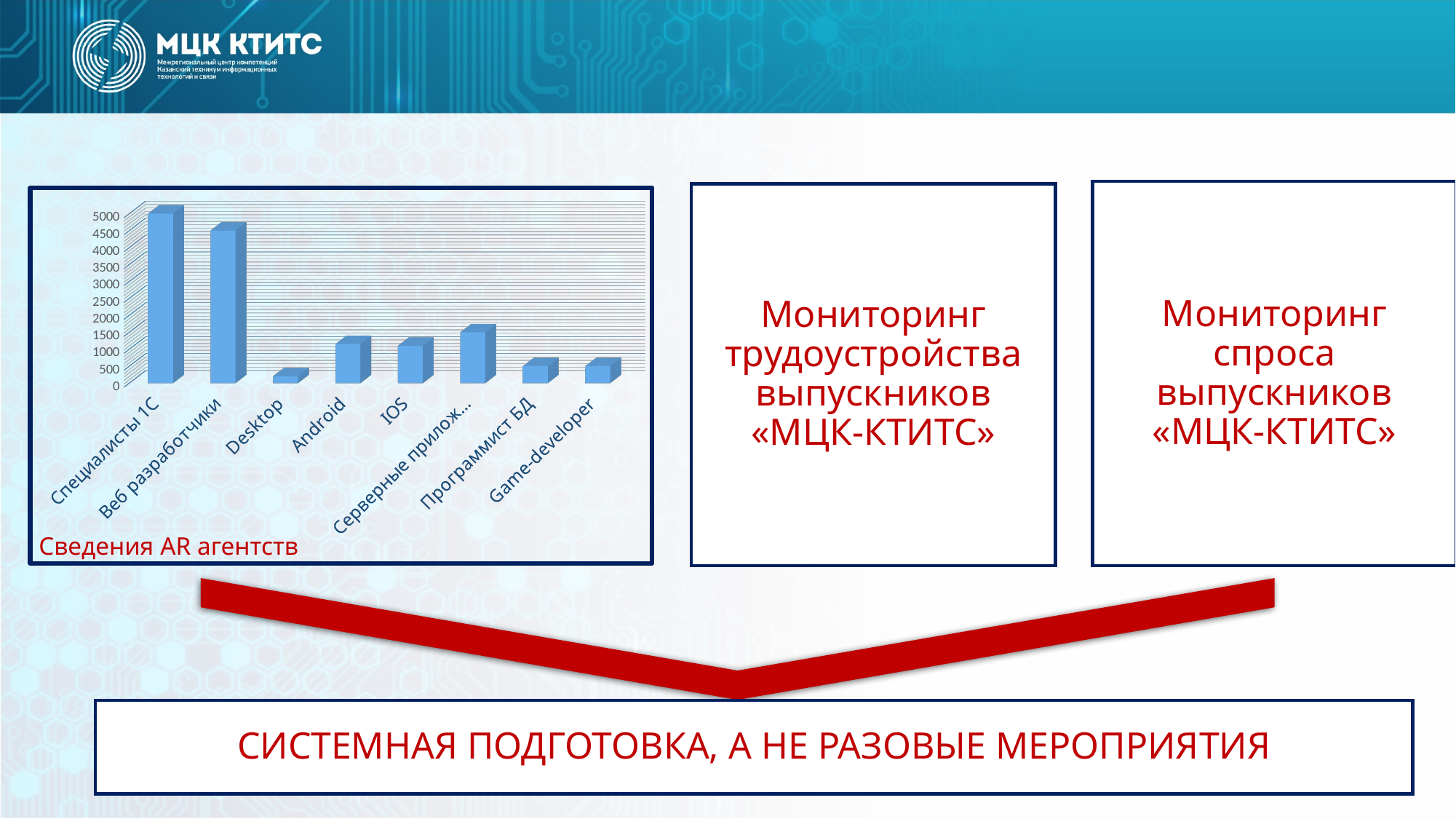
Is the value for Программист БД greater or less than 1000? less Is the value for Desktop greater or less than 500? less Which is larger, the value for Android or the value for Desktop? Android Is the value for Специалисты 1С greater or less than 4000? greater What caption is written below the chart? Сведения AR агентств Which category has the highest bar in the chart? Специалисты 1С How many categories are shown on the x axis of the chart? 8 Which category has the lowest bar in the chart? Desktop Which is larger, the value for Веб разработчики or the value for IOS? Веб разработчики What kind of chart is shown on the slide? Bar chart